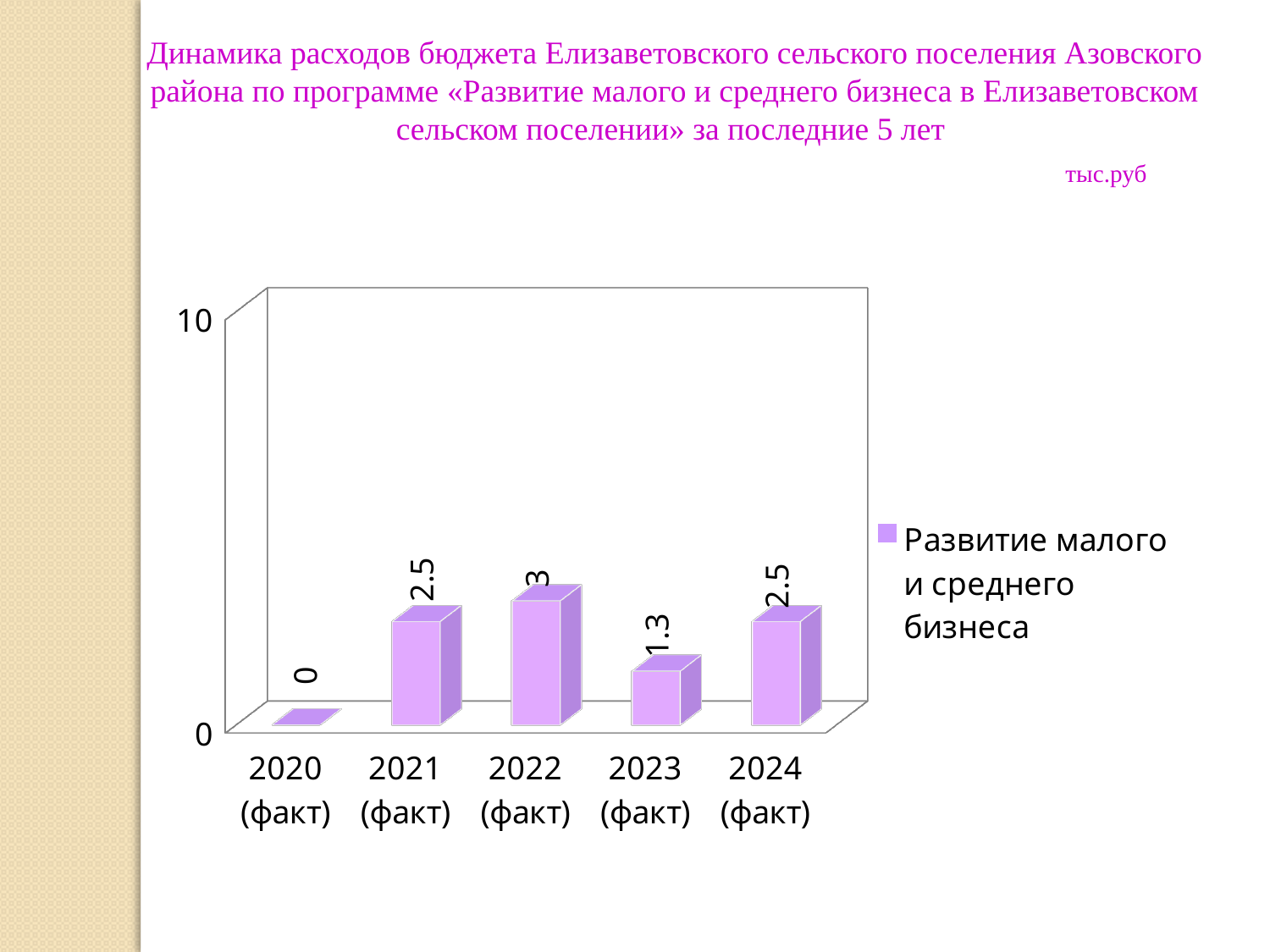
How many series does the legend list? 1 What is the value for 2022 (факт)? 3 Which year has the highest value? 2022 (факт) What kind of chart is shown on the slide? Bar chart What is the value for 2020 (факт)? 0 What is the value for 2023 (факт)? 1.3 What is the name of the series shown in the legend? Развитие малого и среднего бизнеса How many categories are shown on the x axis? 5 Which year has the lowest value? 2020 (факт) Which is larger, the value for 2021 (факт) or the value for 2023 (факт)? 2021 (факт) What is the difference between the values for 2022 (факт) and 2023 (факт)? 1.7 What unit is indicated above the chart? тыс.руб